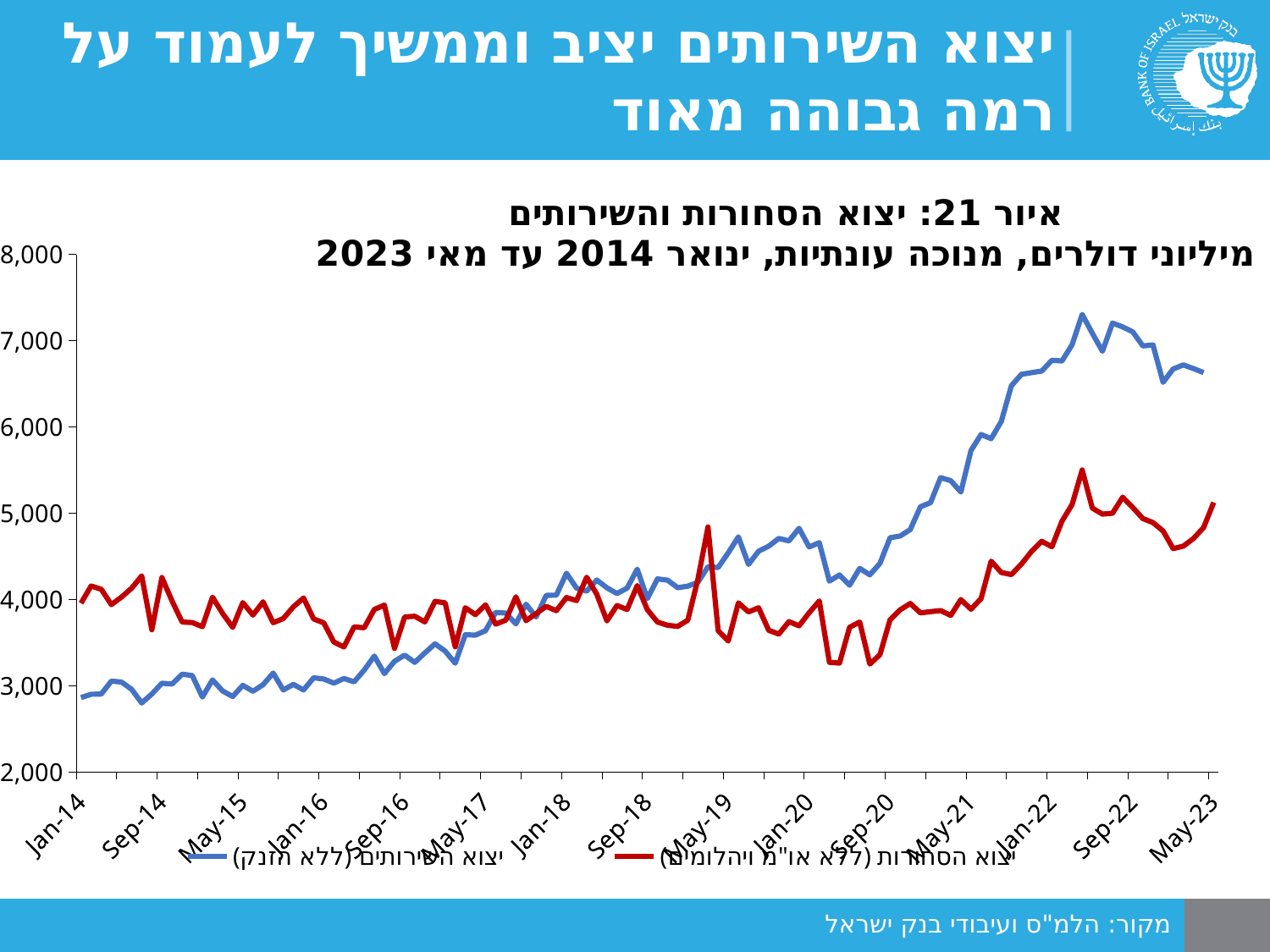
What colour is the line for services exports (יצוא השירותים)? blue How many series does the legend list? 2 Does the blue services exports line generally rise or fall from Jan-14 to May-23? rise Is the value of the blue services exports line at Jan-14 greater or less than 3,000? less Is the value of the red goods exports line around Sep-20 greater or less than 4,000? less Is the value of the blue services exports line at Jan-20 greater or less than 4,000? greater At Jan-14, which line is higher: the blue services exports line or the red goods exports line? red goods exports line What kind of chart is shown on the slide? line chart What is the title of the chart? איור 21: יצוא הסחורות והשירותים מיליוני דולרים, מנוכה עונתיות, ינואר 2014 עד מאי 2023